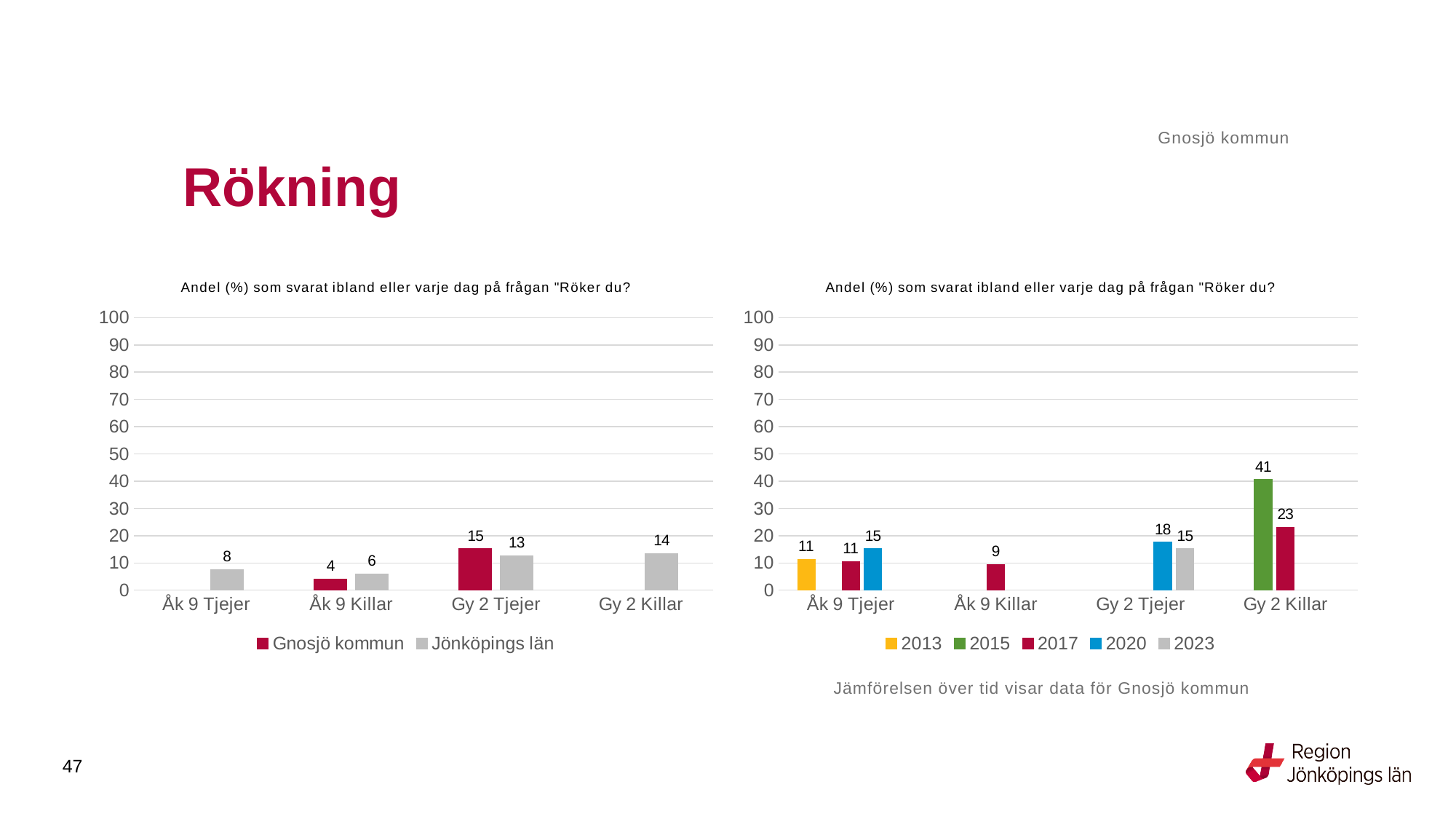
In the right chart, what is the difference between the 2015 and 2017 values for Gy 2 Killar? 18 In the right chart, how many series does the legend list? 5 In the left chart, what is the difference between Gnosjö kommun and Jönköpings län for Gy 2 Tjejer? 2 In the right chart, which year is shown in yellow in the legend? 2013 In the right chart, which is larger for Åk 9 Tjejer: the 2013 value or the 2020 value? 2020 In the left chart, what is the value for Gnosjö kommun for Åk 9 Killar? 4 In the right chart, what is the value for 2020 for Gy 2 Tjejer? 18 In the left chart, how many series does the legend list? 2 In the right chart, what is the value for 2015 for Gy 2 Killar? 41 In the left chart, what is the value for Jönköpings län for Gy 2 Killar? 14 In the left chart, which category has the highest value for Jönköpings län? Gy 2 Killar What kind of chart is the right chart? Bar chart